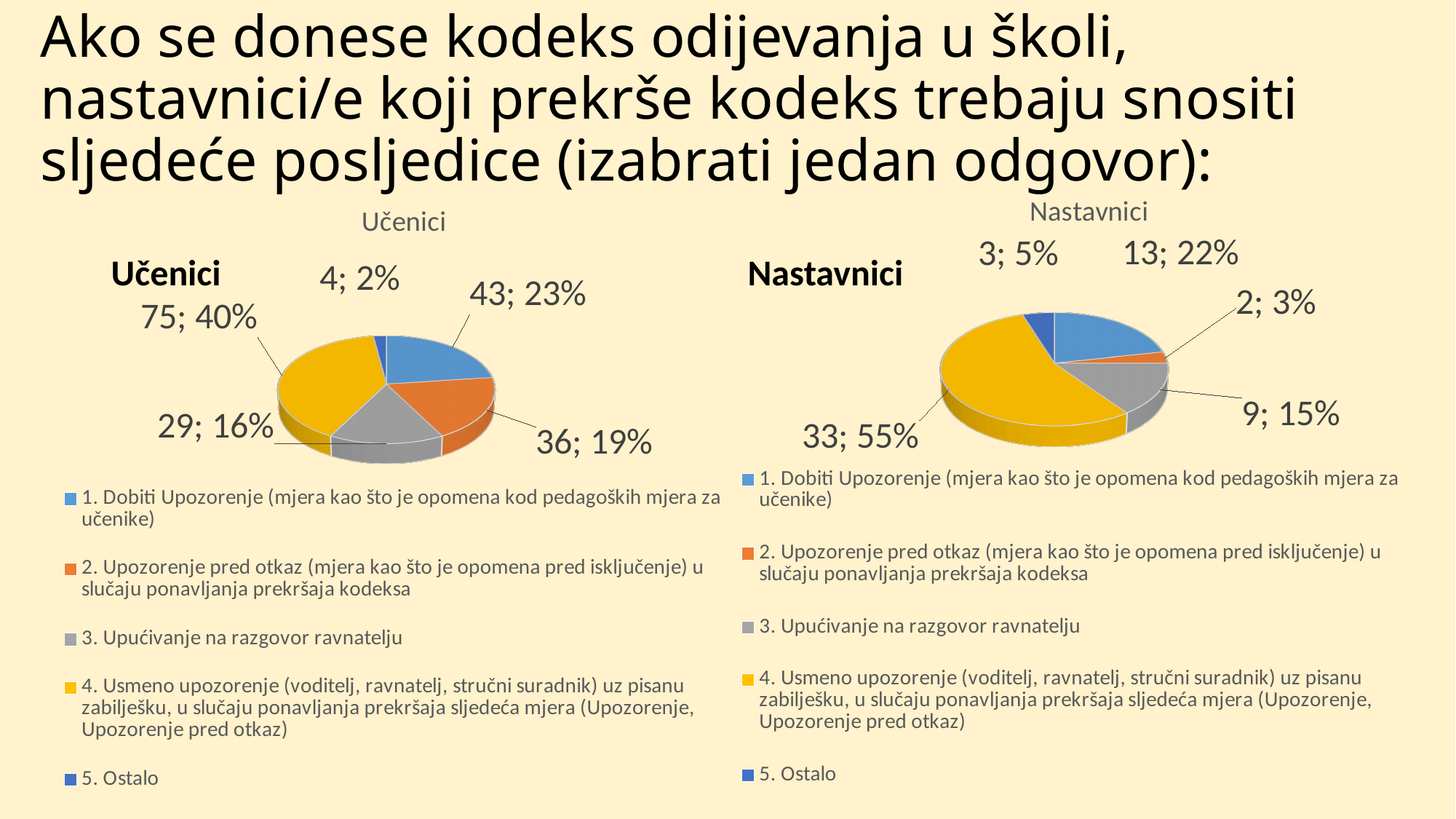
In the Učenici chart, what is the value for '4. Usmeno upozorenje (voditelj, ravnatelj, stručni suradnik) uz pisanu zabilješku...'? 75; 40% In the Nastavnici chart, what share of the pie does '5. Ostalo' take? 5% In the Nastavnici chart, what is the value for '1. Dobiti Upozorenje (mjera kao što je opomena kod pedagoških mjera za učenike)'? 13; 22% In the Nastavnici chart, which category has the smallest slice? 2. Upozorenje pred otkaz (mjera kao što je opomena pred isključenje) u slučaju ponavljanja prekršaja kodeksa In the Nastavnici chart, which is larger: '3. Upućivanje na razgovor ravnatelju' or '5. Ostalo'? 3. Upućivanje na razgovor ravnatelju What type of chart is the Nastavnici chart? Pie chart How many categories does the Učenici chart show? 5 In the Učenici chart, what is the difference in count between '1. Dobiti Upozorenje' and '2. Upozorenje pred otkaz'? 7 In the Učenici chart, which category has the smallest slice? 5. Ostalo In the Učenici chart, what is the value for '3. Upućivanje na razgovor ravnatelju'? 29; 16% In the Nastavnici chart, which category has the largest slice? 4. Usmeno upozorenje (voditelj, ravnatelj, stručni suradnik) uz pisanu zabilješku, u slučaju ponavljanja prekršaja sljedeća mjera (Upozorenje, Upozorenje pred otkaz) In the Učenici chart, what share of the pie does '2. Upozorenje pred otkaz' take? 19%